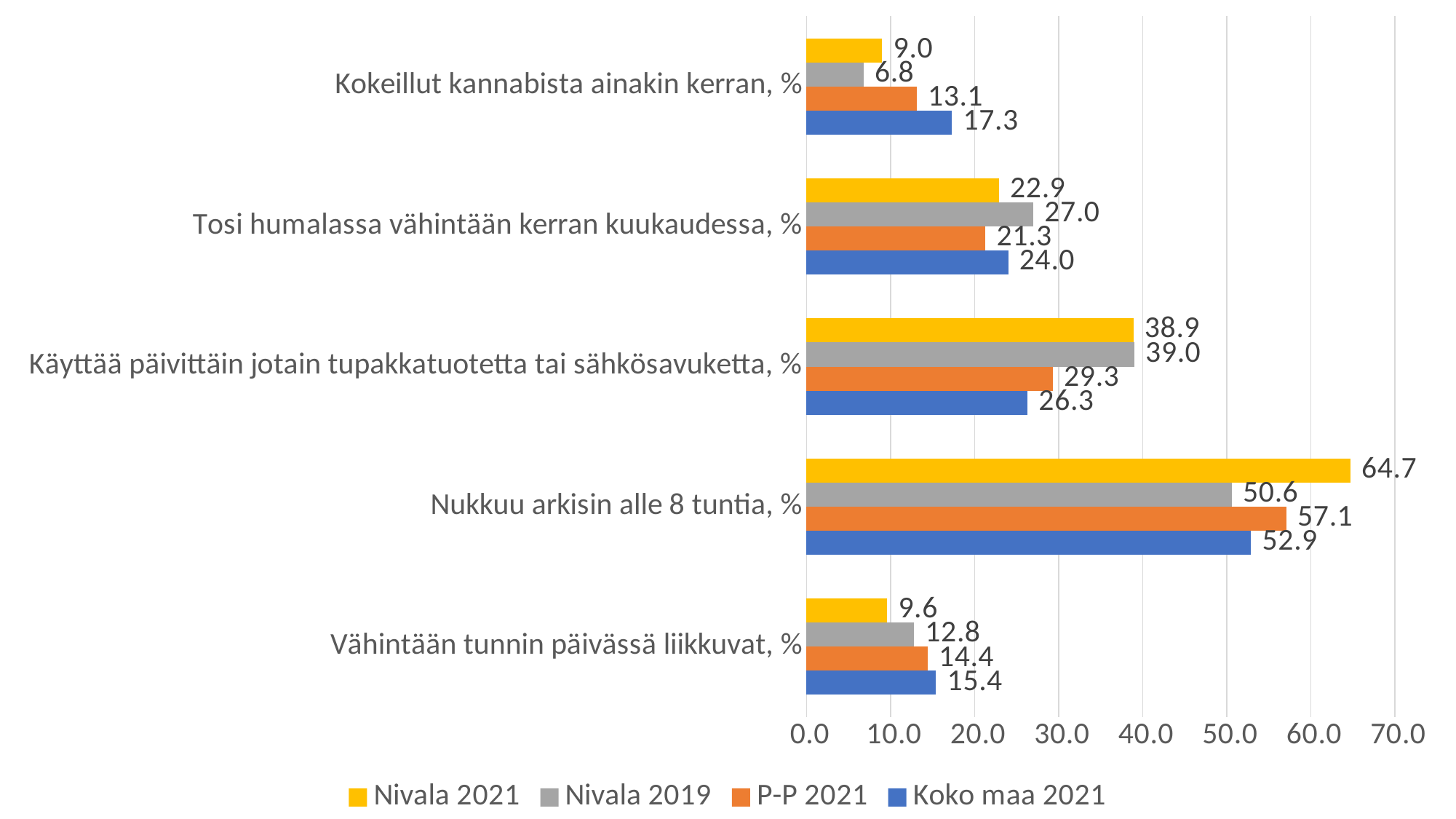
How many series does the legend list? 4 Which category has the lowest value for Nivala 2019? Kokeillut kannabista ainakin kerran, % What is the value for P-P 2021 in the category "Vähintään tunnin päivässä liikkuvat, %"? 14.4 How many categories are shown on the chart? 5 Which category has the highest value for Nivala 2021? Nukkuu arkisin alle 8 tuntia, % Which colour represents the Koko maa 2021 series? Blue What is the value for Koko maa 2021 in the category "Kokeillut kannabista ainakin kerran, %"? 17.3 What kind of chart is shown on the slide? Bar chart What is the value for Nivala 2019 in the category "Tosi humalassa vähintään kerran kuukaudessa, %"? 27.0 In the category "Käyttää päivittäin jotain tupakkatuotetta tai sähkösavuketta, %", which is larger: P-P 2021 or Koko maa 2021? P-P 2021 What is the difference between Nivala 2021 and Nivala 2019 in the category "Nukkuu arkisin alle 8 tuntia, %"? 14.1 What is the value for Nivala 2021 in the category "Nukkuu arkisin alle 8 tuntia, %"? 64.7